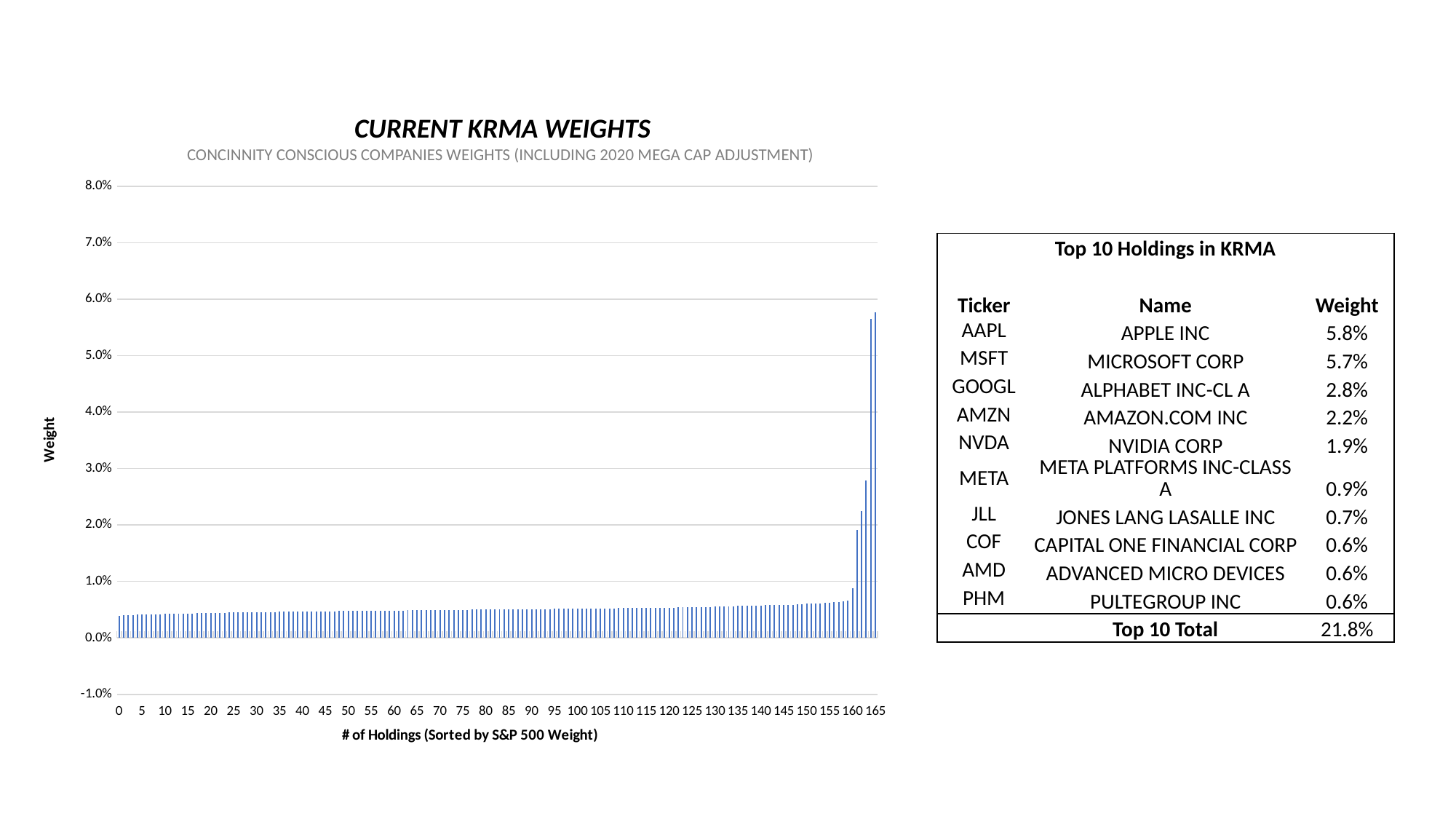
Do the bar values rise or fall moving left to right along the x axis? rise What is the label of the x axis of the chart? # of Holdings (Sorted by S&P 500 Weight) How many bars in the chart exceed 3.0%? 2 What kind of chart is shown on the slide? bar chart Is the value of the bar at holding 100 greater or less than 1.0%? less Is the value of the bar at holding 50 greater or less than 2.0%? less How many bars in the chart exceed 5.0%? 2 Is the value of the tallest bar greater or less than 6.0%? less What is the title of the chart? CURRENT KRMA WEIGHTS